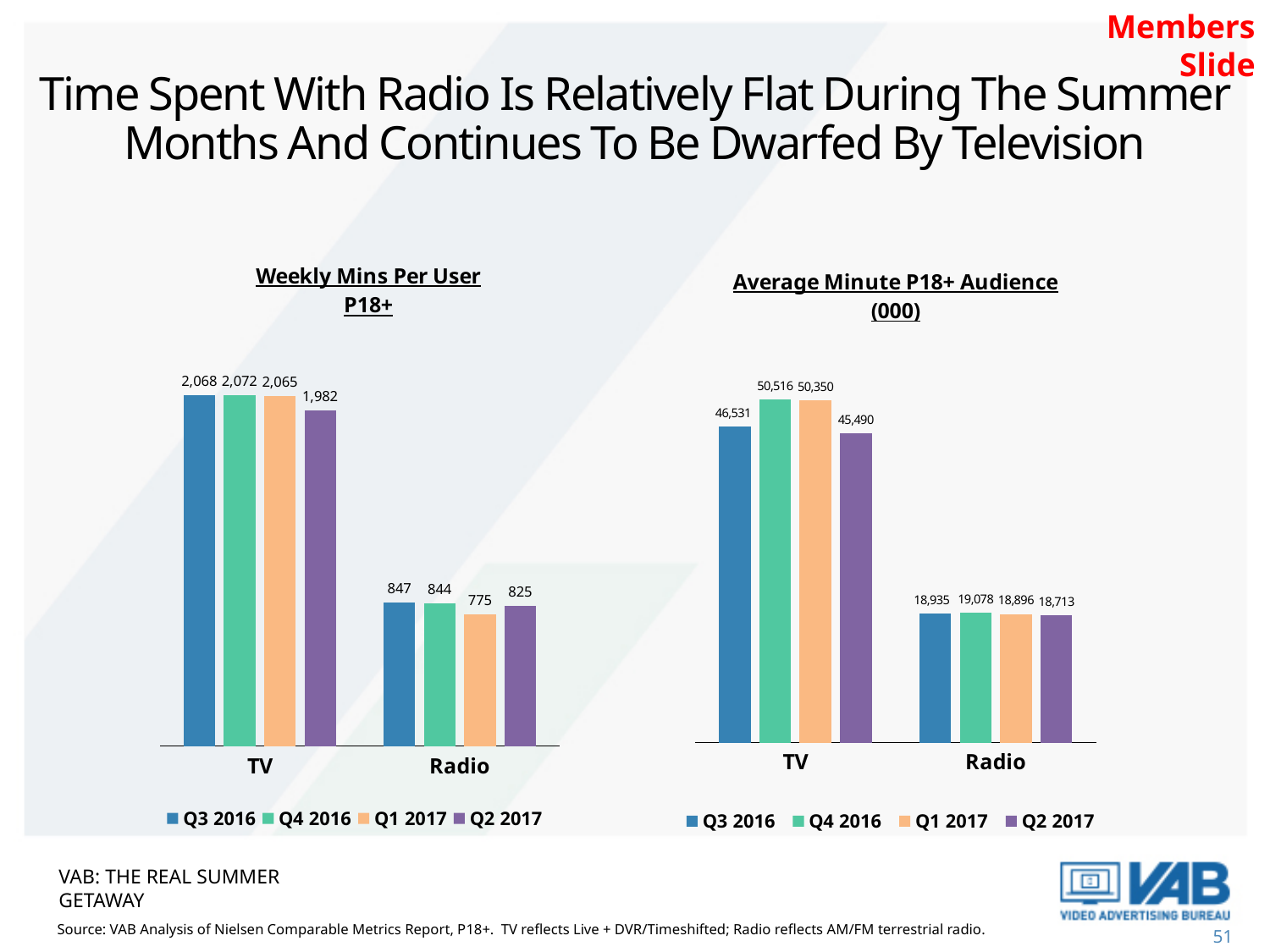
How many series does the legend of the Average Minute P18+ Audience (000) chart list? 4 In the Average Minute P18+ Audience (000) chart, what is the difference between the Q4 2016 and Q3 2016 values for TV? 3,985 What type of chart is the Average Minute P18+ Audience (000) chart? Bar chart In the Average Minute P18+ Audience (000) chart, what is the value for Radio in Q2 2017? 18,713 In the Average Minute P18+ Audience (000) chart, which quarter has the lowest value for TV? Q2 2017 In the Weekly Mins Per User P18+ chart, what is the value for Radio in Q1 2017? 775 In the Weekly Mins Per User P18+ chart, which quarter has the lowest value for Radio? Q1 2017 In the Average Minute P18+ Audience (000) chart, what is the value for TV in Q4 2016? 50,516 In the Weekly Mins Per User P18+ chart, which is larger for Radio: Q3 2016 or Q2 2017? Q3 2016 In the Weekly Mins Per User P18+ chart, what is the difference between the TV and Radio values for Q3 2016? 1,221 In the Weekly Mins Per User P18+ chart, what is the value for TV in Q2 2017? 1,982 How many categories are shown on the x axis of the Weekly Mins Per User P18+ chart? 2